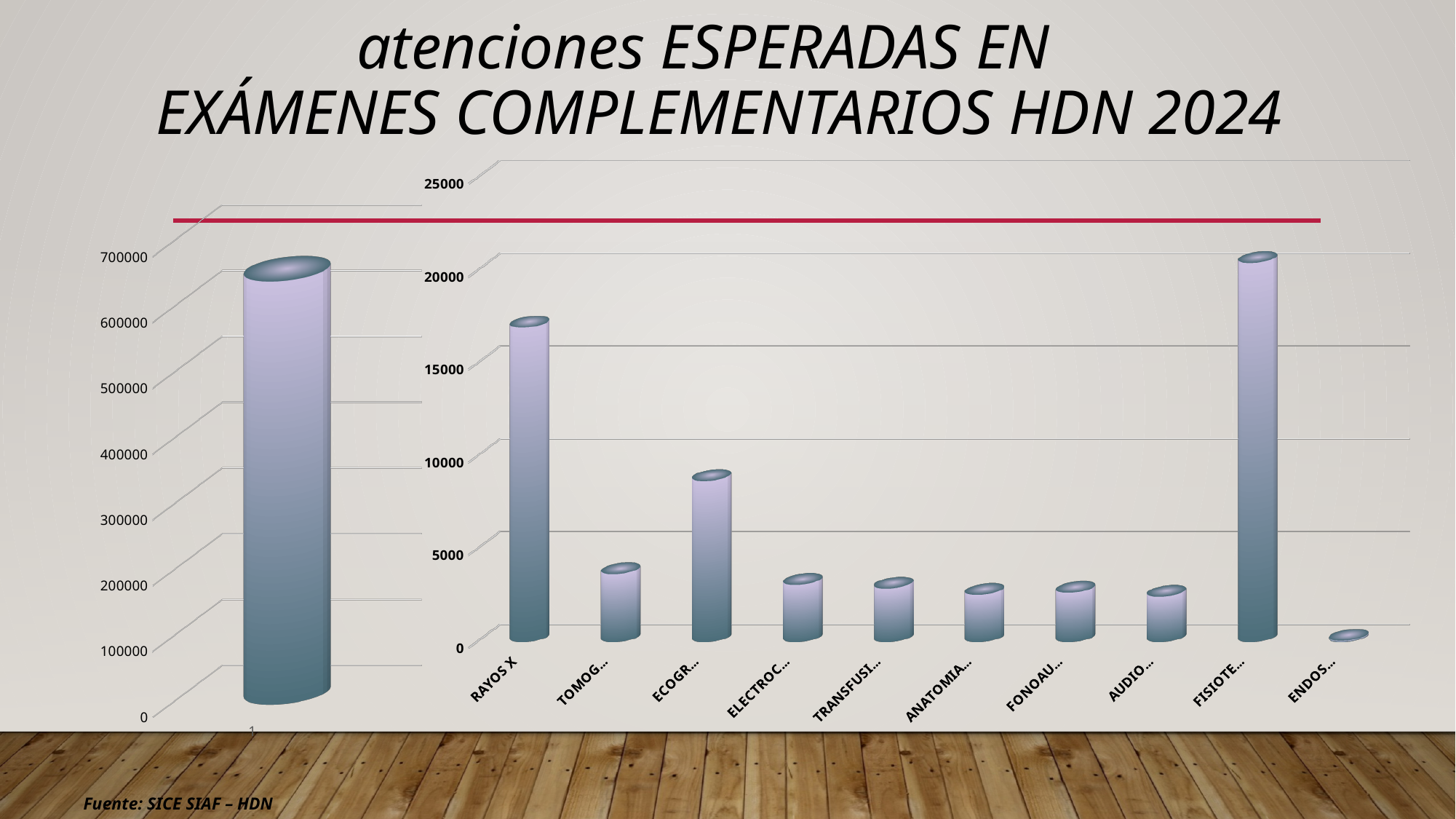
On the right-hand chart, which is larger, the value for FISIOTE... or the value for RAYOS X? FISIOTE... On the right-hand chart, which is larger, the value for RAYOS X or the value for ECOGR...? RAYOS X On the right-hand chart, is the value for RAYOS X greater or less than 15000? greater On the right-hand chart, which category has the highest value? FISIOTE... What kind of chart is the right-hand chart? bar chart On the right-hand chart, is the value for TOMOG... greater or less than 5000? less On the left-hand chart, is the value of the single bar greater or less than 600000? greater How many categories are shown on the right-hand chart? 10 On the right-hand chart, which category has the lowest value? ENDOS... What is the title of the slide? atenciones ESPERADAS EN EXÁMENES COMPLEMENTARIOS HDN 2024